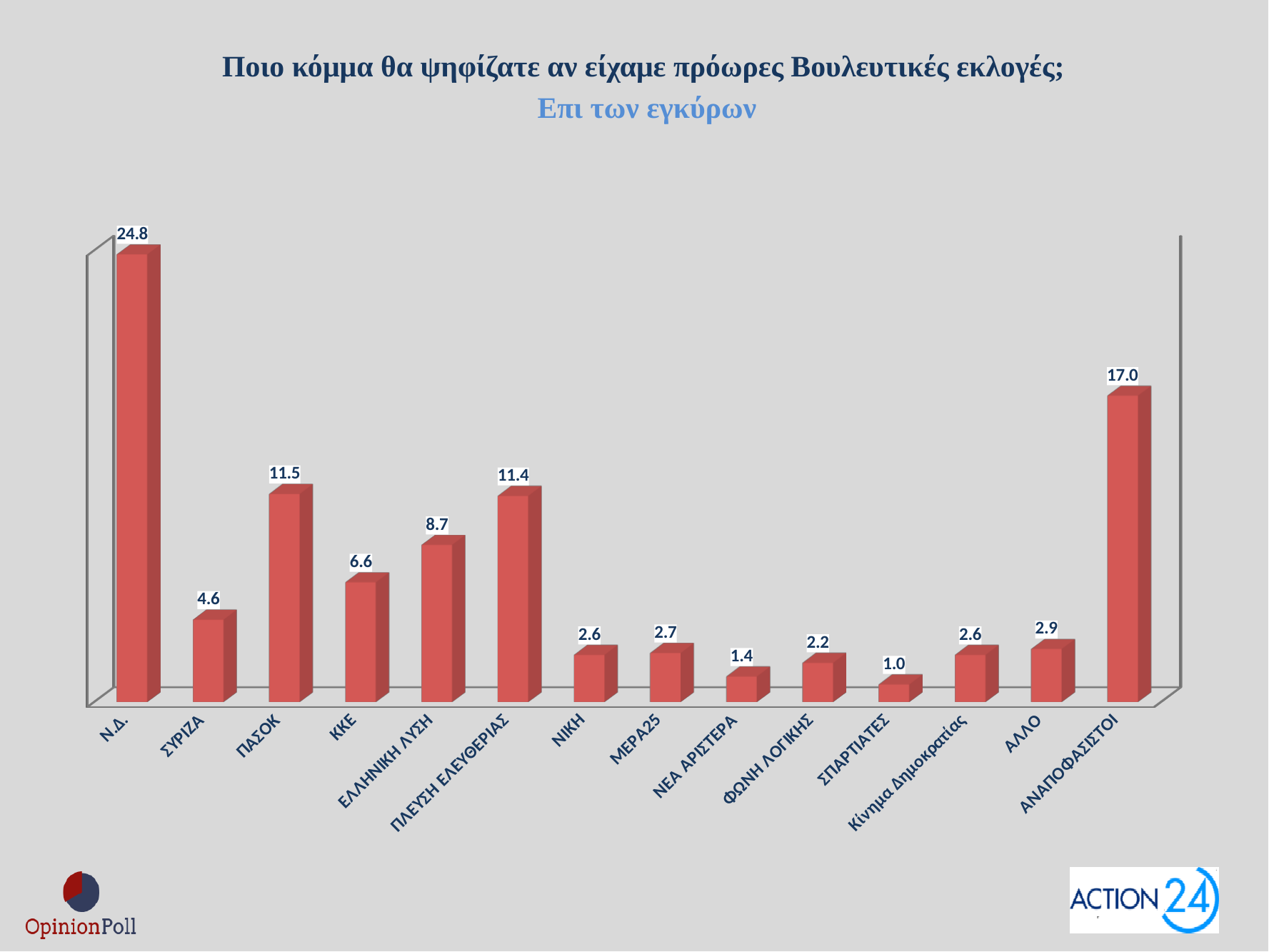
What is the subtitle shown below the chart title? Επι των εγκύρων Which category has the highest value? Ν.Δ. Which category has the lowest value? ΣΠΑΡΤΙΑΤΕΣ What is the value for Ν.Δ.? 24.8 Which is larger, the value for ΚΚΕ or the value for ΣΥΡΙΖΑ? ΚΚΕ How many categories are shown on the x axis? 14 What is the value for ΣΠΑΡΤΙΑΤΕΣ? 1.0 What is the difference between the values for ΠΑΣΟΚ and ΣΥΡΙΖΑ? 6.9 What is the value for ΕΛΛΗΝΙΚΗ ΛΥΣΗ? 8.7 What kind of chart is shown on the slide? Bar chart What is the value for ΑΝΑΠΟΦΑΣΙΣΤΟΙ? 17.0 What is the difference between the values for Ν.Δ. and ΑΝΑΠΟΦΑΣΙΣΤΟΙ? 7.8